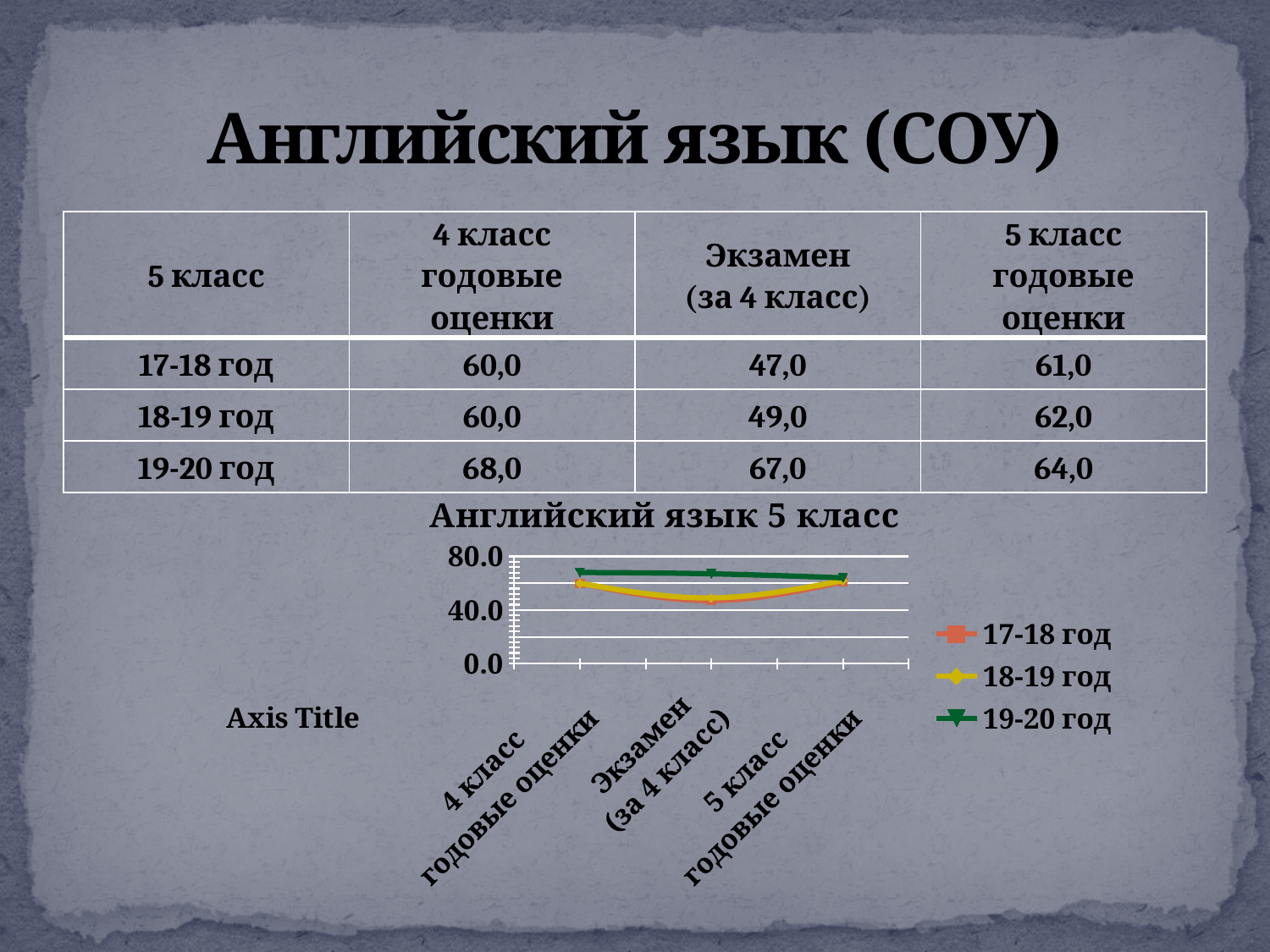
What is the title of the chart? Английский язык 5 класс Do the values for the 19-20 год series rise or fall from left to right along the x axis? fall What is the value for 17-18 год at 4 класс годовые оценки? 60,0 Is the value for 18-19 год at Экзамен (за 4 класс) greater or less than 80? less How many series does the chart legend list? 3 How many categories are shown along the x axis of the chart? 3 At Экзамен (за 4 класс), which series has the larger value, 19-20 год or 17-18 год? 19-20 год What kind of chart is shown on the slide? line chart For the 17-18 год series, which category has the lowest value? Экзамен (за 4 класс) For the 19-20 год series, which category has the highest value? 4 класс годовые оценки What is the difference between the 19-20 год and 17-18 год values at Экзамен (за 4 класс)? 20,0 What is the value for 19-20 год at Экзамен (за 4 класс)? 67,0